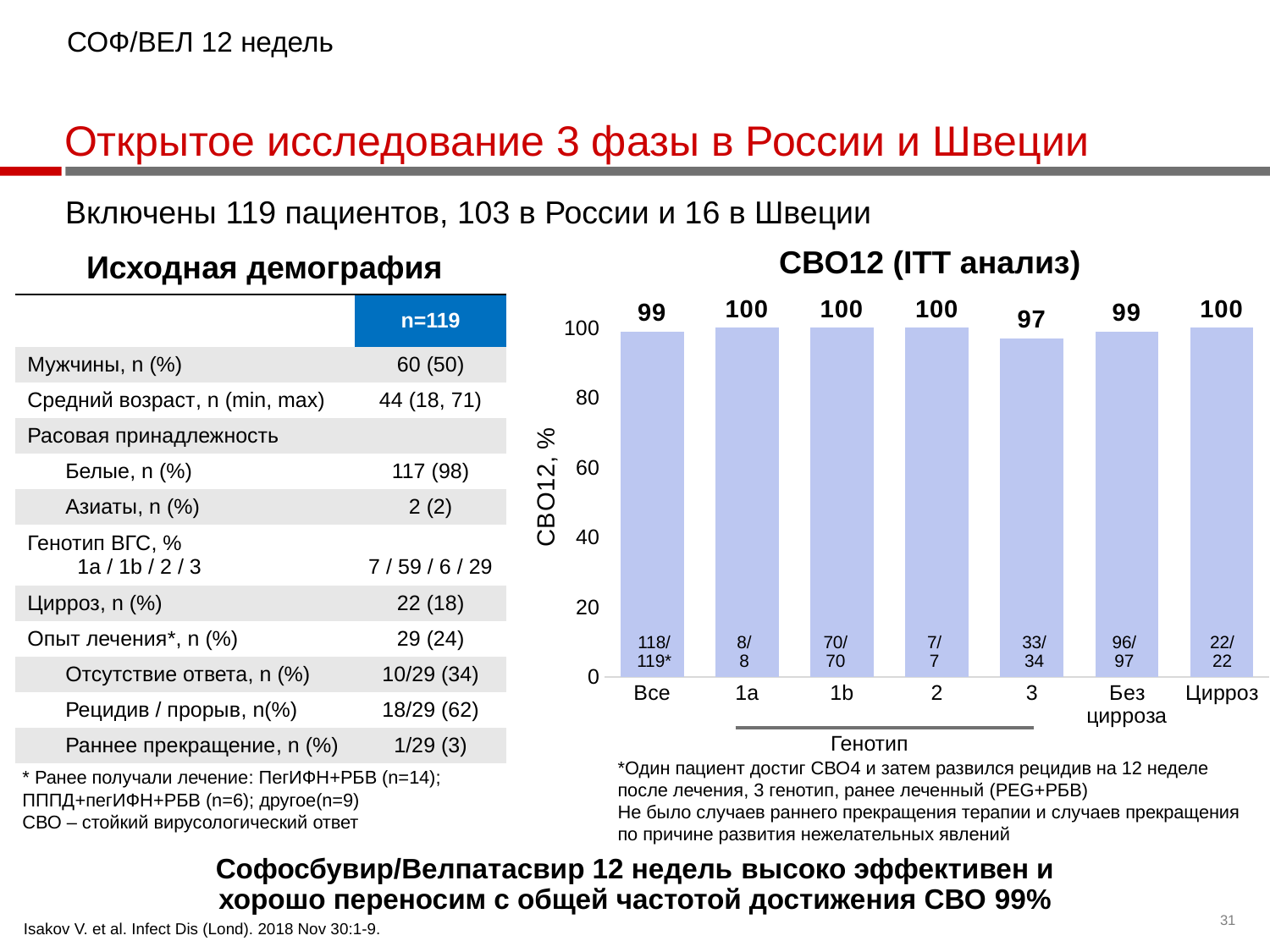
What fraction is printed inside the bar for genotype 3? 33/34 What type of chart is shown on the slide? bar chart What is the СВО12 value for the category "Все"? 99 What is the СВО12 value for genotype 3? 97 What is the y-axis label of the chart? СВО12, % Which is larger, the СВО12 value for "Цирроз" or for "Без цирроза"? Цирроз What is the СВО12 value for the category "Цирроз"? 100 What is the difference between the СВО12 values for genotype 1a and genotype 3? 3 What is the СВО12 value for the category "Без цирроза"? 99 What is the title of the chart? СВО12 (ITT анализ) Which category has the lowest СВО12 value? 3 How many categories are shown on the x axis of the chart? 7